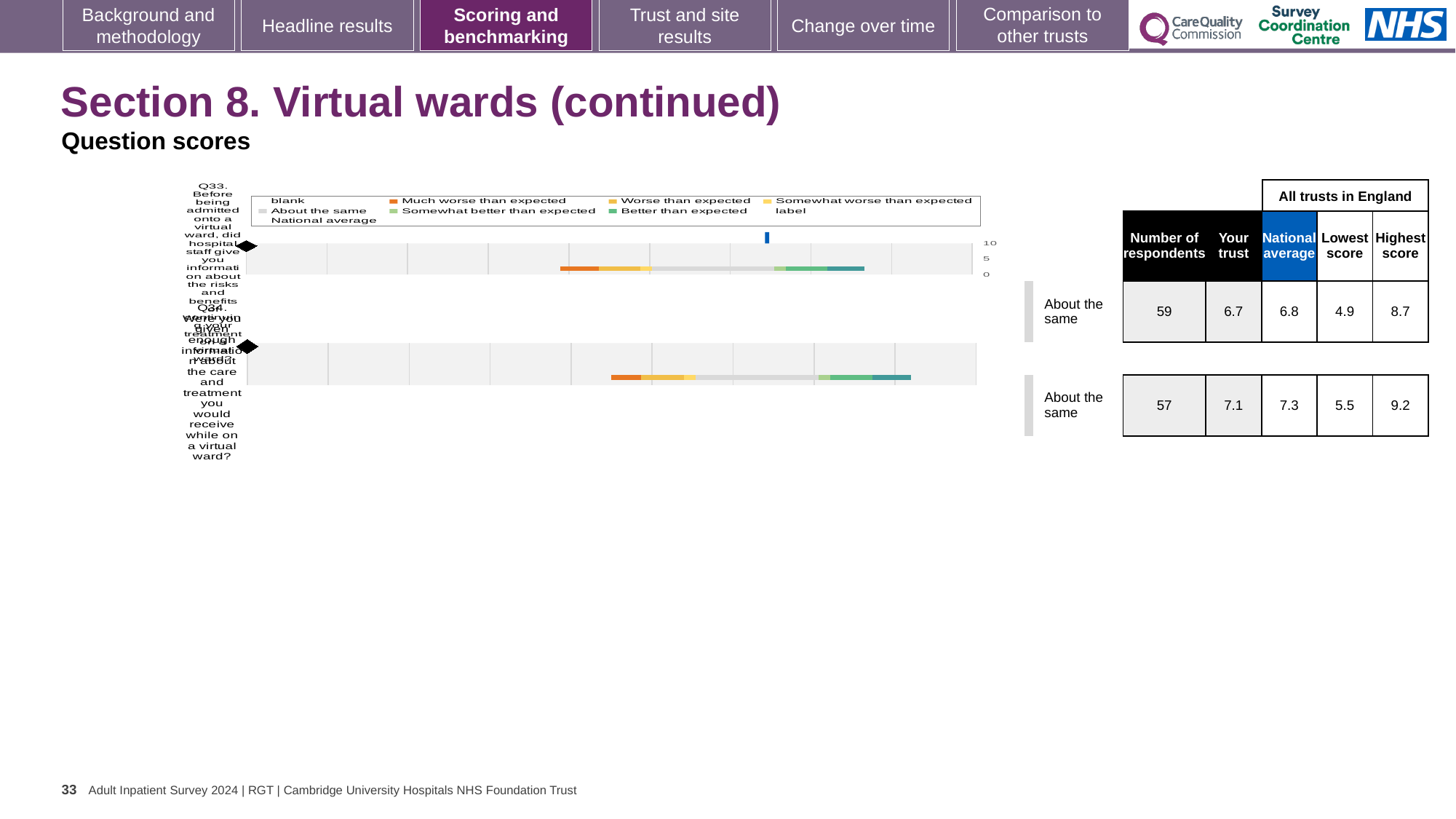
What kind of chart is used to show the question scores for Q33 and Q34? bar chart What is the difference between the national average and the 'Your trust' score for Q33? 0.1 What is the lowest score among all trusts in England for Q33? 4.9 Which question has the higher 'Your trust' score, Q33 or Q34? Q34 How many respondents answered Q33? 59 What is the national average score for Q34? 7.3 What is the 'Your trust' score for Q33? 6.7 What colour represents 'Much worse than expected' in the legend? orange What is the difference between the highest and lowest scores for Q34? 3.7 How many questions are plotted in the chart? 2 What benchmark category is shown for Q33? About the same